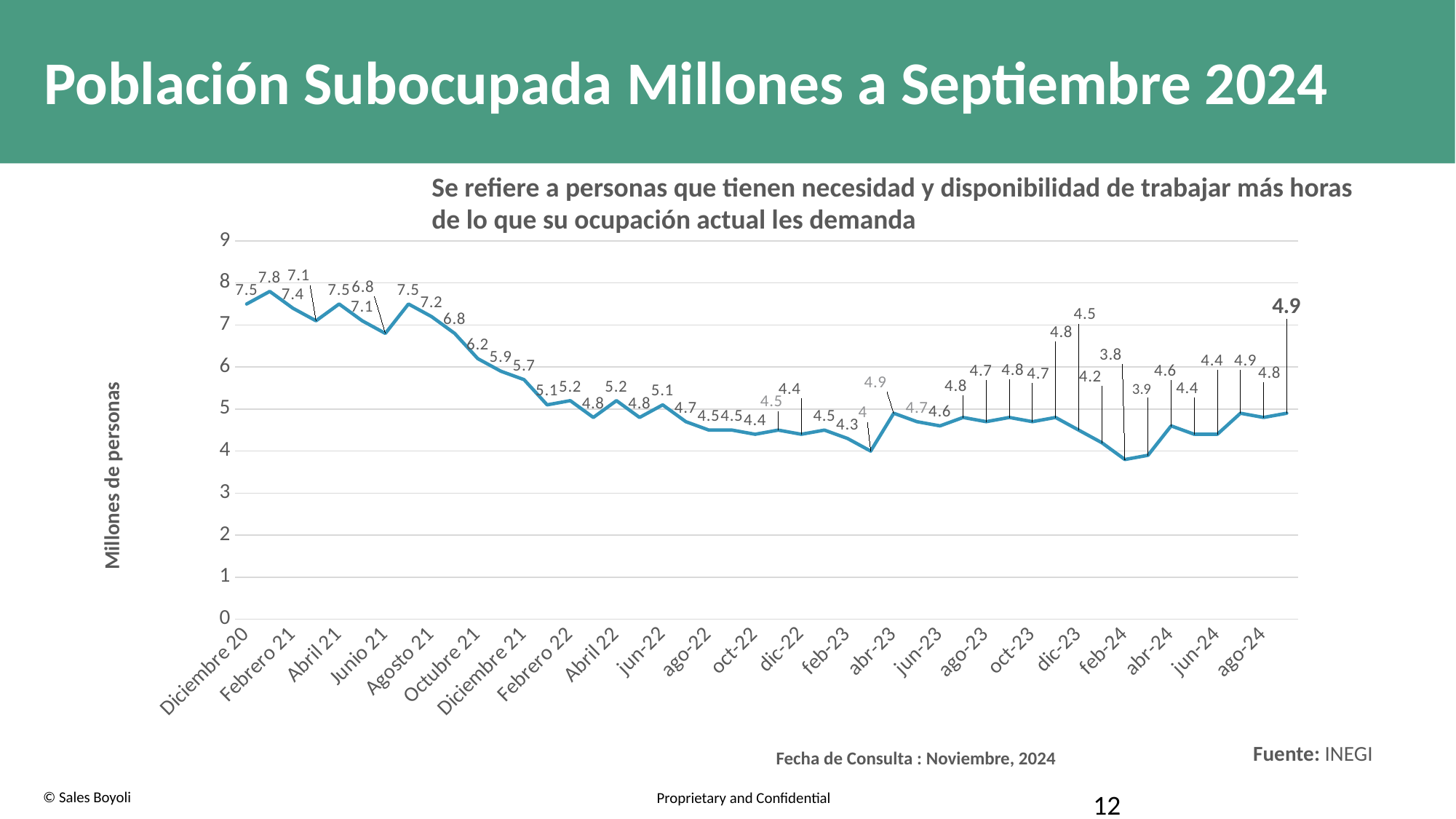
Which x-axis label corresponds to the lowest point of the line? feb-24 Is the value for feb-24 greater or less than 4? less Which is larger, the value for Diciembre 20 or the value for Septiembre 2024? Diciembre 20 What is the highest value plotted on the chart? 7.8 Is the value for Junio 21 greater or less than 7? less What is the title of the vertical axis? Millones de personas Overall, do the values rise or fall from Diciembre 20 to Septiembre 2024? fall What is the difference between the value for Diciembre 20 and the value for Septiembre 2024? 2.6 What is the value for the last point, Septiembre 2024? 4.9 What type of chart is shown on the slide? line chart What is the lowest value plotted on the chart? 3.8 What is the value for Diciembre 20? 7.5